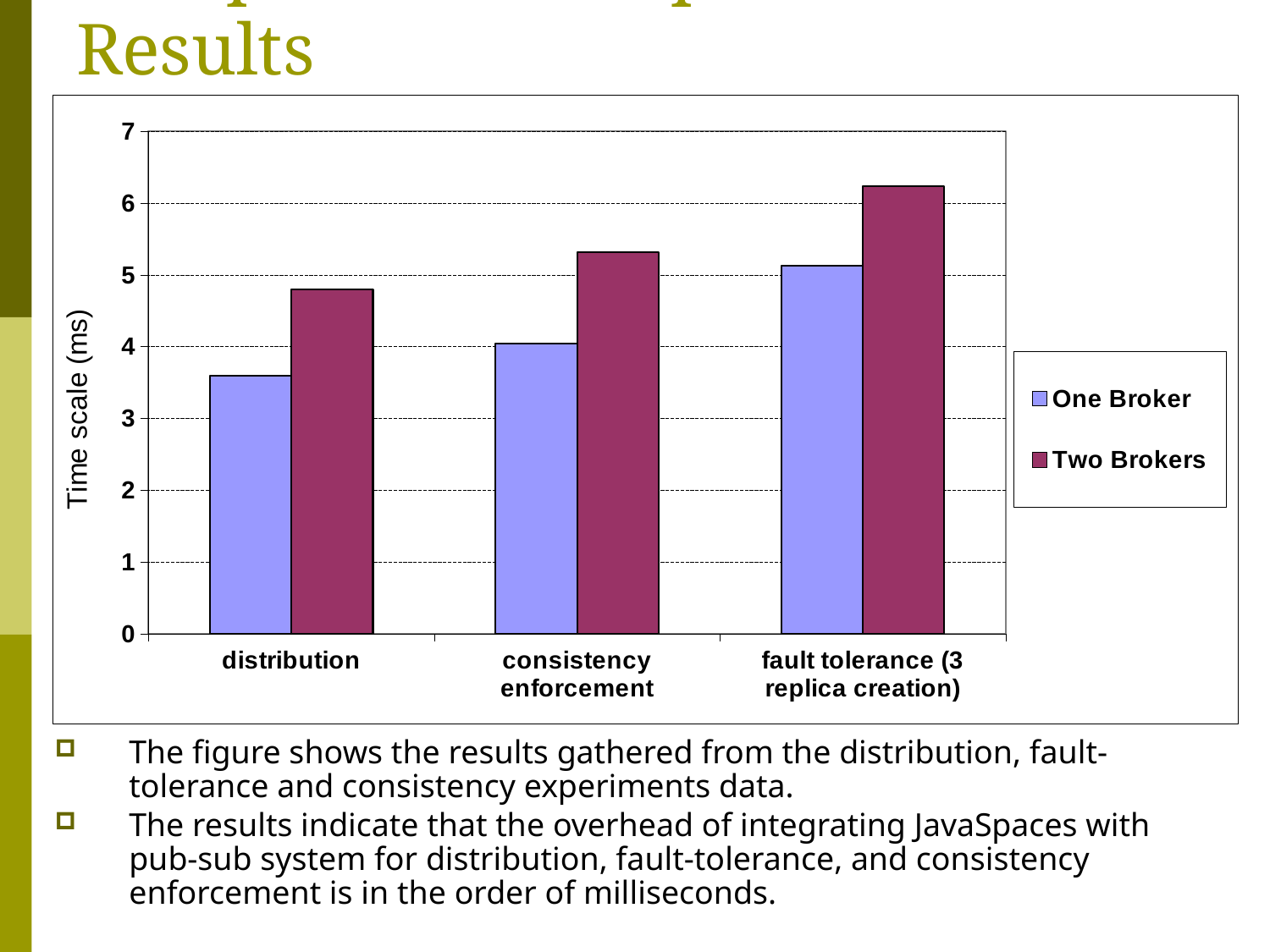
What is the label of the chart's vertical axis? Time scale (ms) Do the One Broker values rise or fall from left to right across the categories? rise Is the Two Brokers value for fault tolerance (3 replica creation) greater or less than 6? greater For the distribution category, which series has the larger value, One Broker or Two Brokers? Two Brokers Is the One Broker value for distribution greater or less than 4? less Is the Two Brokers value for consistency enforcement greater or less than 5? greater How many categories are shown on the x axis of the chart? 3 Which category has the highest One Broker value? fault tolerance (3 replica creation) How many series does the chart's legend list? 2 Which category has the lowest Two Brokers value? distribution What kind of chart is shown on the slide? bar chart